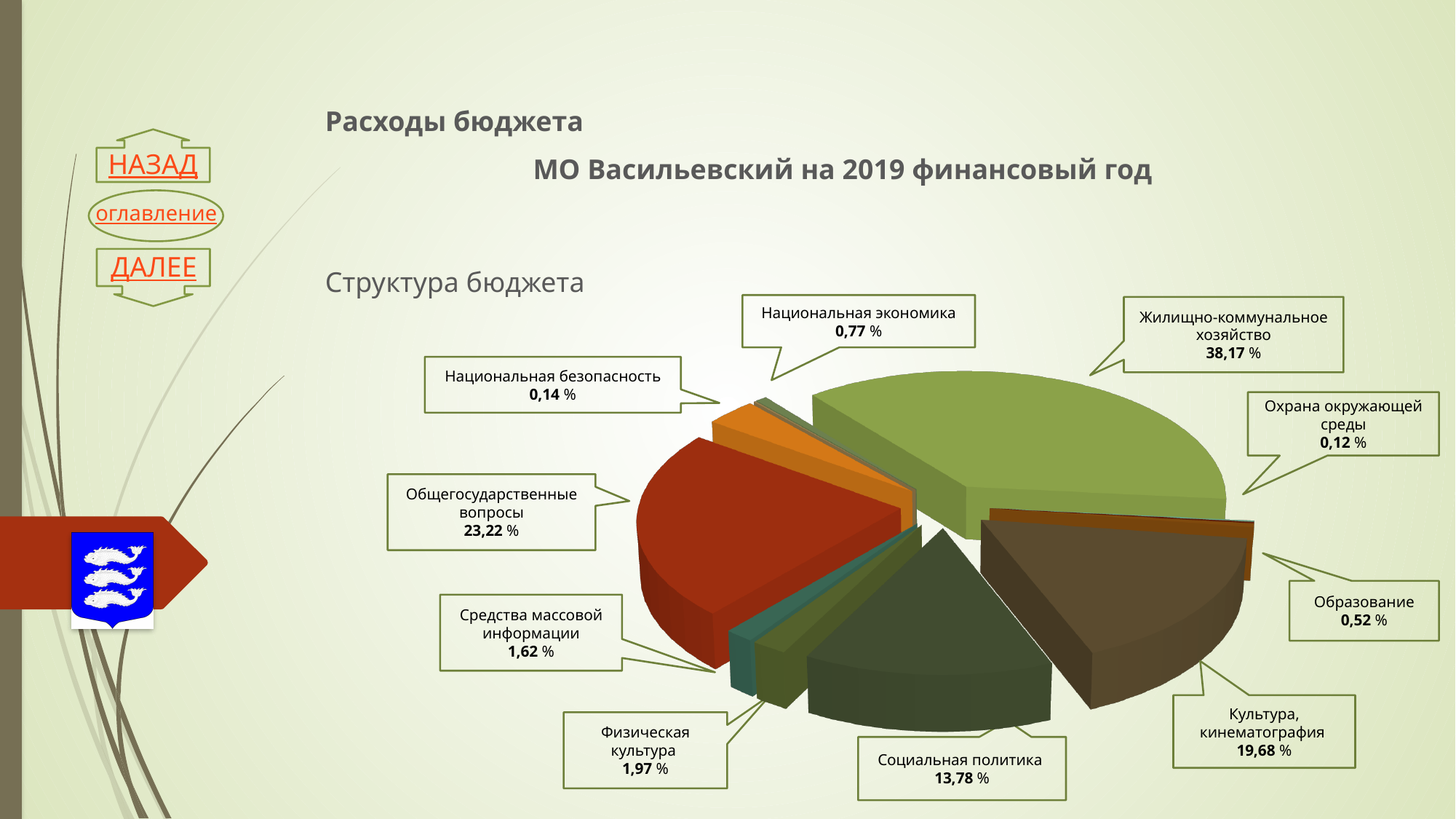
What is the difference between the shares of Жилищно-коммунальное хозяйство and Общегосударственные вопросы? 14,95 % What is the value shown for Социальная политика? 13,78 % Which is larger: the share for Общегосударственные вопросы or for Культура, кинематография? Общегосударственные вопросы What share of the budget goes to Жилищно-коммунальное хозяйство? 38,17 % What is the value shown for Образование? 0,52 % Which category has the largest share of the pie? Жилищно-коммунальное хозяйство Which category has the smallest share of the pie? Охрана окружающей среды What is the value shown for Физическая культура? 1,97 % What is the title of the chart section on the slide? Структура бюджета What is the difference between the shares of Культура, кинематография and Социальная политика? 5,90 % What kind of chart is shown on the slide? pie chart